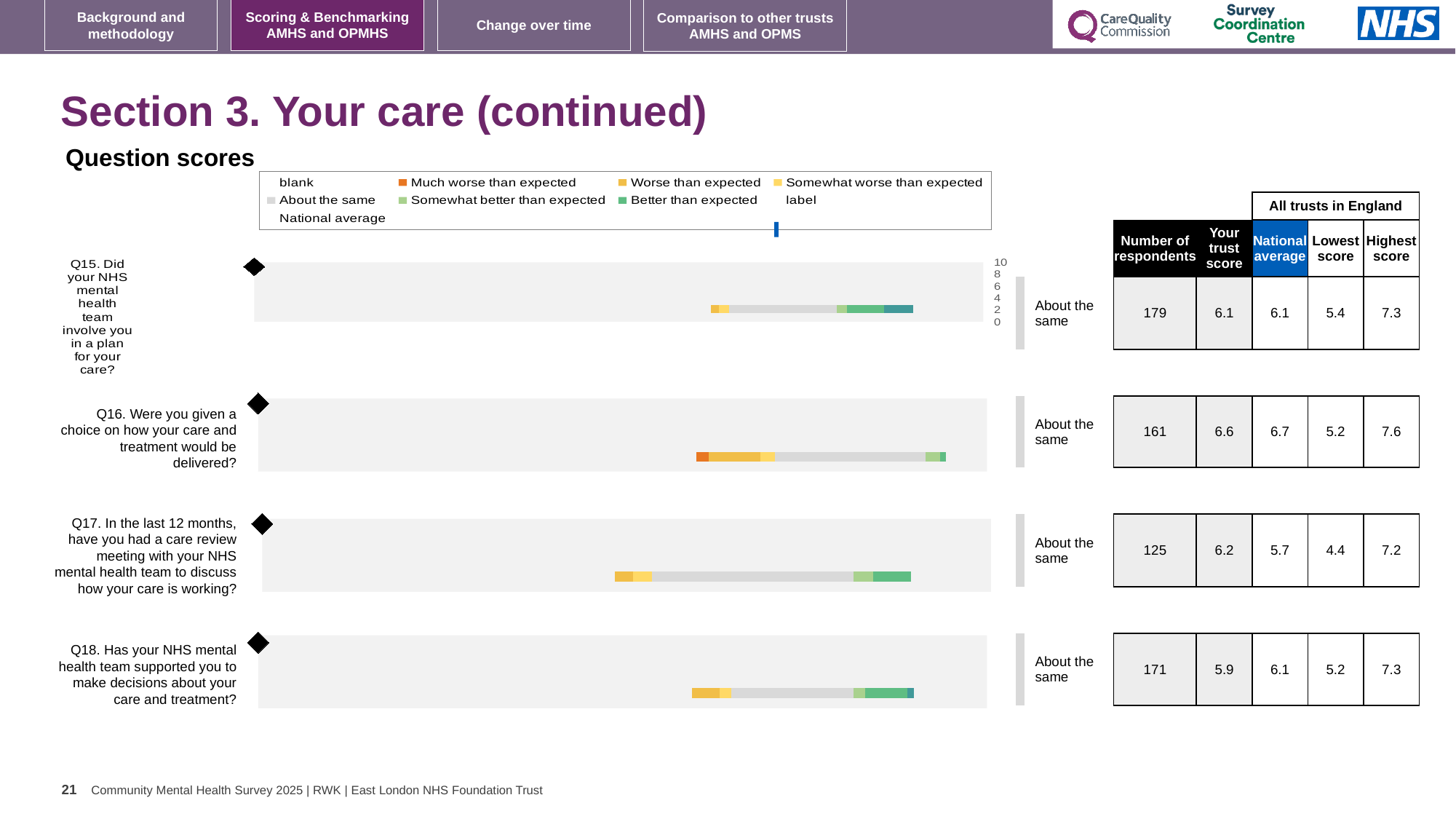
In the legend above the bar charts, which entry is shown with an orange marker? Much worse than expected Which question (Q15 to Q18) has the lowest number of respondents in the table? Q17 What is the difference between the highest score and the lowest score for Q17 in the table? 2.8 What is the highest value shown on the vertical axis next to the Q15 bar chart? 10 Which question (Q15 to Q18) has the highest 'Your trust score' in the table? Q16 In the table beside the Q17 bar chart, what is the national average? 5.7 In the table beside the Q18 bar chart, what is the lowest score among all trusts in England? 5.2 In the table beside the Q16 bar chart, what is the trust's score? 6.6 What kind of chart is used to show the question scores for Q15 to Q18? bar chart How many entries does the legend above the bar charts list? 9 How many question bar charts (Q15 to Q18) are shown on the slide? 4 In the table beside the Q15 bar chart, what is the number of respondents? 179